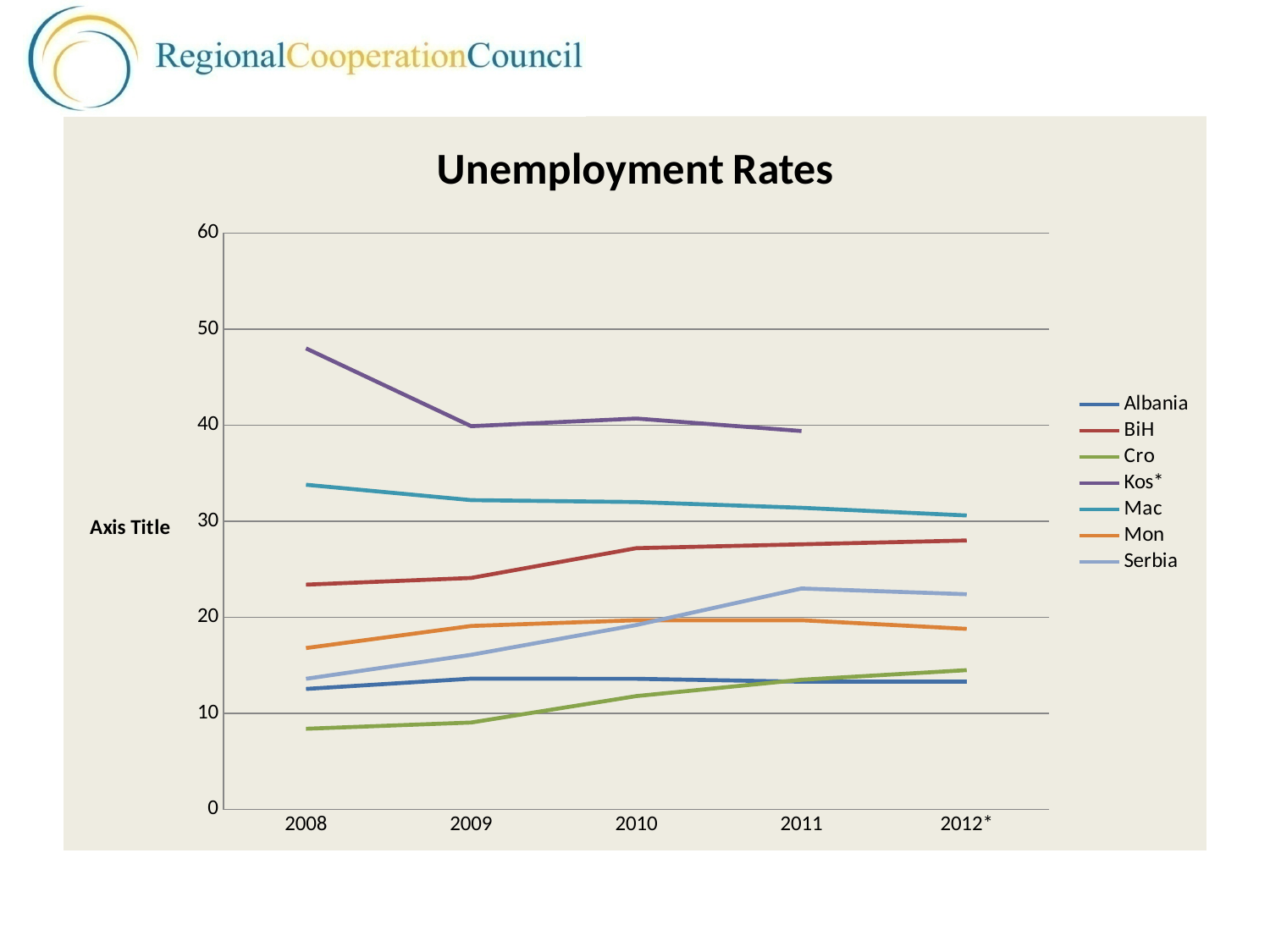
What is the title of the chart? Unemployment Rates Is the value for Cro in 2008 greater or less than 10? less Is the value for Kos* in 2008 greater or less than 40? greater Which series has the lowest unemployment rate in 2008? Cro Is the value for BiH in 2012* greater or less than 30? less What type of chart is shown on the slide? Line chart How many series does the legend list? 7 Does the Cro line rise or fall from 2008 to 2012*? Rise How many years are shown on the x axis? 5 In 2010, which is larger, the value for Mac or the value for BiH? Mac Does the Kos* line rise or fall from 2008 to 2011? Fall Which series has the highest unemployment rate in 2008? Kos*